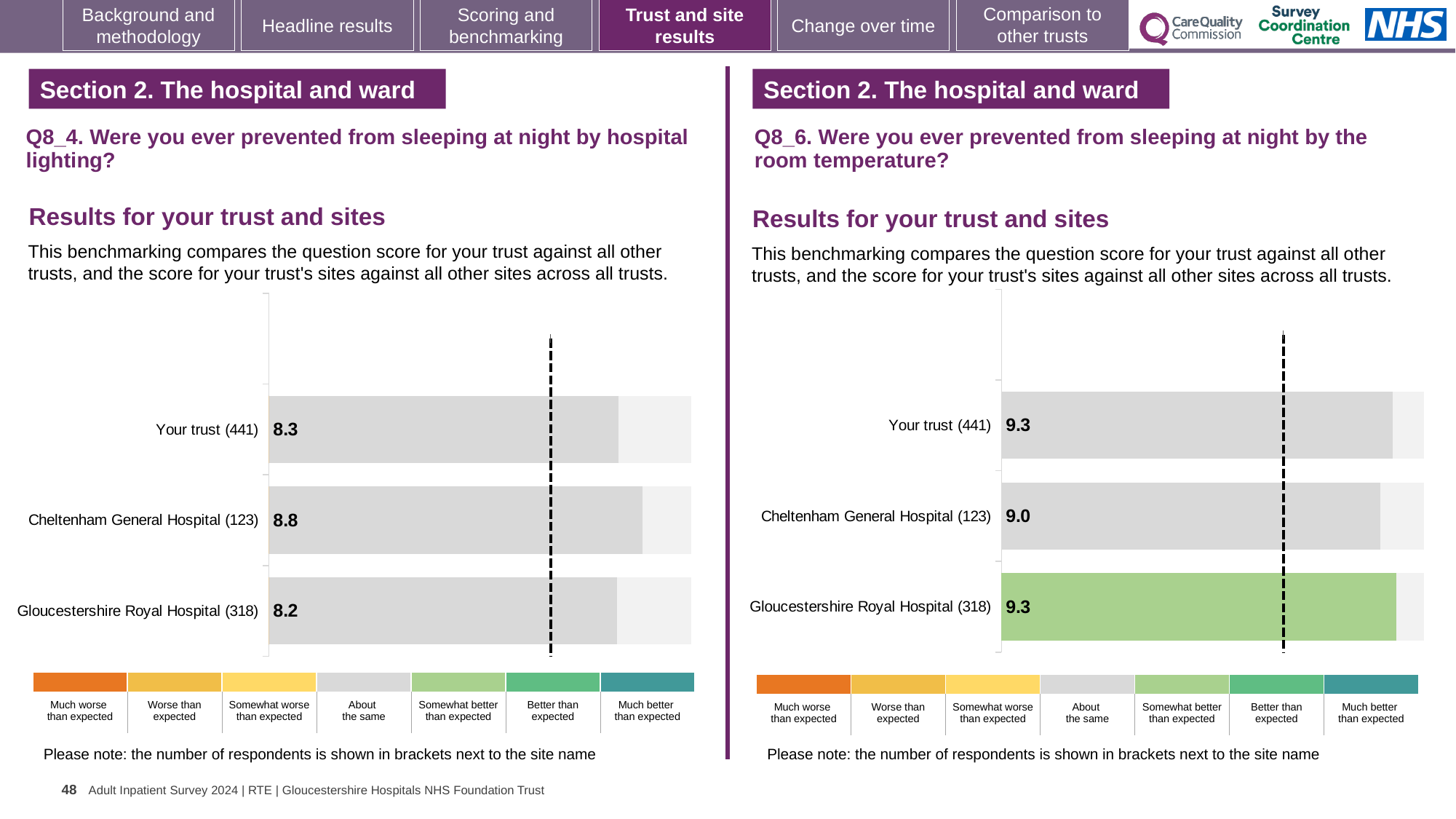
In the Q8_4 chart about hospital lighting, what is the score for Your trust (441)? 8.3 In the Q8_4 chart about hospital lighting, what is the score for Gloucestershire Royal Hospital (318)? 8.2 In the Q8_6 chart about room temperature, what is the score for Gloucestershire Royal Hospital (318)? 9.3 In the Q8_6 chart about room temperature, what is the score for Cheltenham General Hospital (123)? 9.0 In the Q8_4 chart about hospital lighting, which site or trust has the highest score? Cheltenham General Hospital (123) In the Q8_4 chart about hospital lighting, what is the difference between the scores for Cheltenham General Hospital and Gloucestershire Royal Hospital? 0.6 In the Q8_6 chart about room temperature, which is larger: the score for Your trust or the score for Cheltenham General Hospital? Your trust In the Q8_4 chart about hospital lighting, what is the score for Cheltenham General Hospital (123)? 8.8 How many bars are plotted in the Q8_4 chart about hospital lighting? 3 In the Q8_6 chart about room temperature, what is the score for Your trust (441)? 9.3 In the Q8_6 chart about room temperature, which site has the lowest score? Cheltenham General Hospital (123) What kind of chart is used in the Q8_6 chart about room temperature? Bar chart